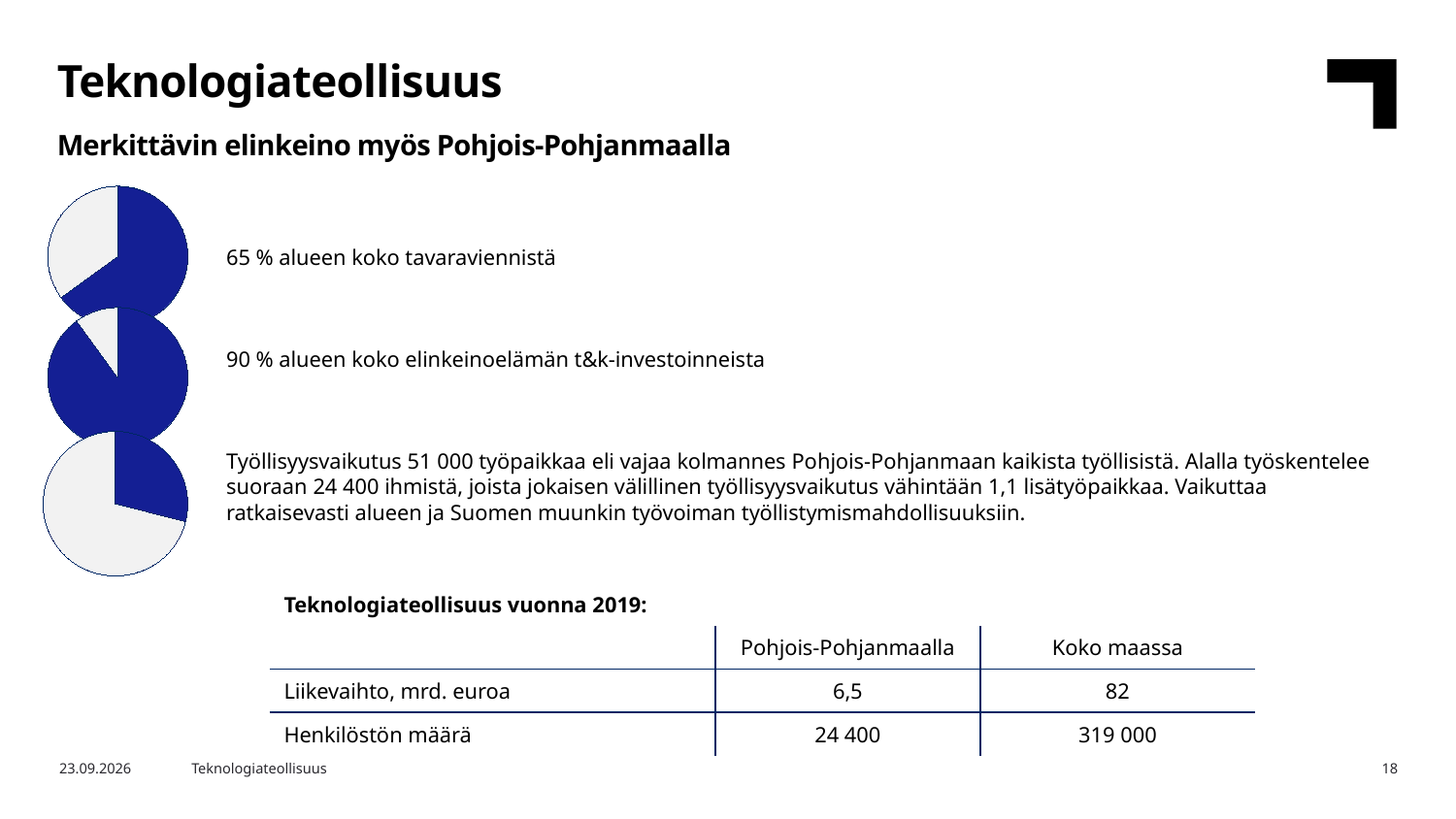
What kind of charts are shown on the left side of the slide? Pie charts What colour is used for the highlighted slice in each pie chart? Blue What does the top pie chart represent according to the text next to it? 65 % alueen koko tavaraviennistä Which of the three pie charts has the smallest blue slice? The bottom one (työllisyysvaikutus) Is the blue slice larger in the top pie chart (tavaravienti) or in the middle pie chart (t&k-investoinnit)? Middle pie chart (t&k-investoinnit) How many pie charts are on the slide? 3 In the top pie chart (alueen koko tavaravienti), what share does the blue slice represent? 65 % In the middle pie chart (t&k-investoinnit), is the blue slice greater or less than 75 %? greater Which of the three pie charts has the largest blue slice? The middle one (t&k-investoinnit, 90 %) In the bottom pie chart (työllisyysvaikutus), is the blue slice greater or less than 50 %? less In the middle pie chart (alueen koko elinkeinoelämän t&k-investoinnit), what share does the blue slice represent? 90 % What is the difference in percentage points between the blue share of the middle pie chart (90 %) and the top pie chart (65 %)? 25 percentage points